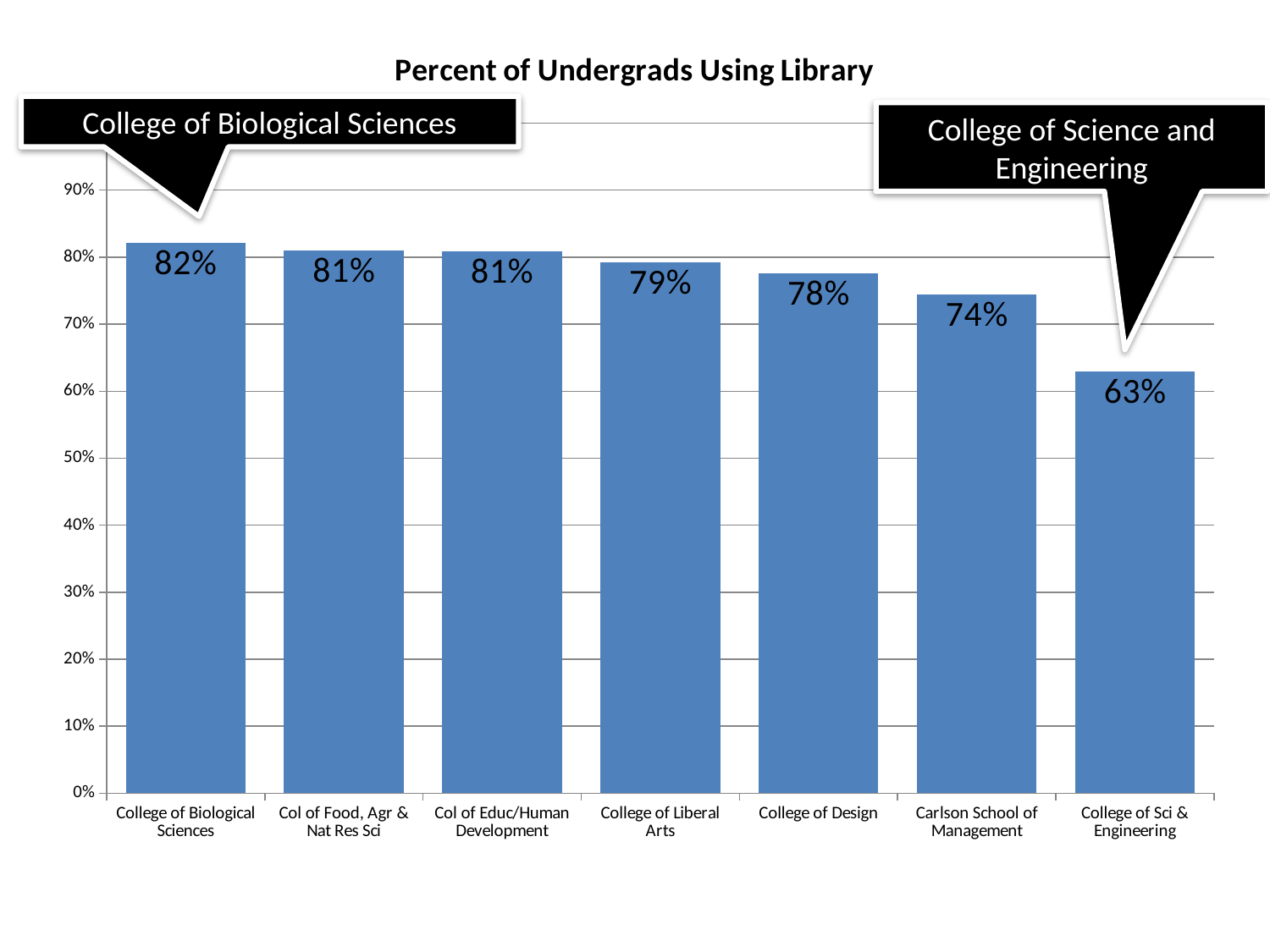
Which category has the lowest value? College of Sci & Engineering How many categories are shown on the chart? 7 What is the value for College of Design? 78% What is the difference between the values for College of Biological Sciences and College of Sci & Engineering? 19% What is the title of the chart? Percent of Undergrads Using Library What kind of chart is this? bar chart What is the value for Carlson School of Management? 74% Which category has the highest value? College of Biological Sciences Is the value for College of Sci & Engineering greater or less than 70%? less What is the value for College of Sci & Engineering? 63% What is the value for College of Biological Sciences? 82% Which is larger, the value for College of Liberal Arts or the value for Carlson School of Management? College of Liberal Arts